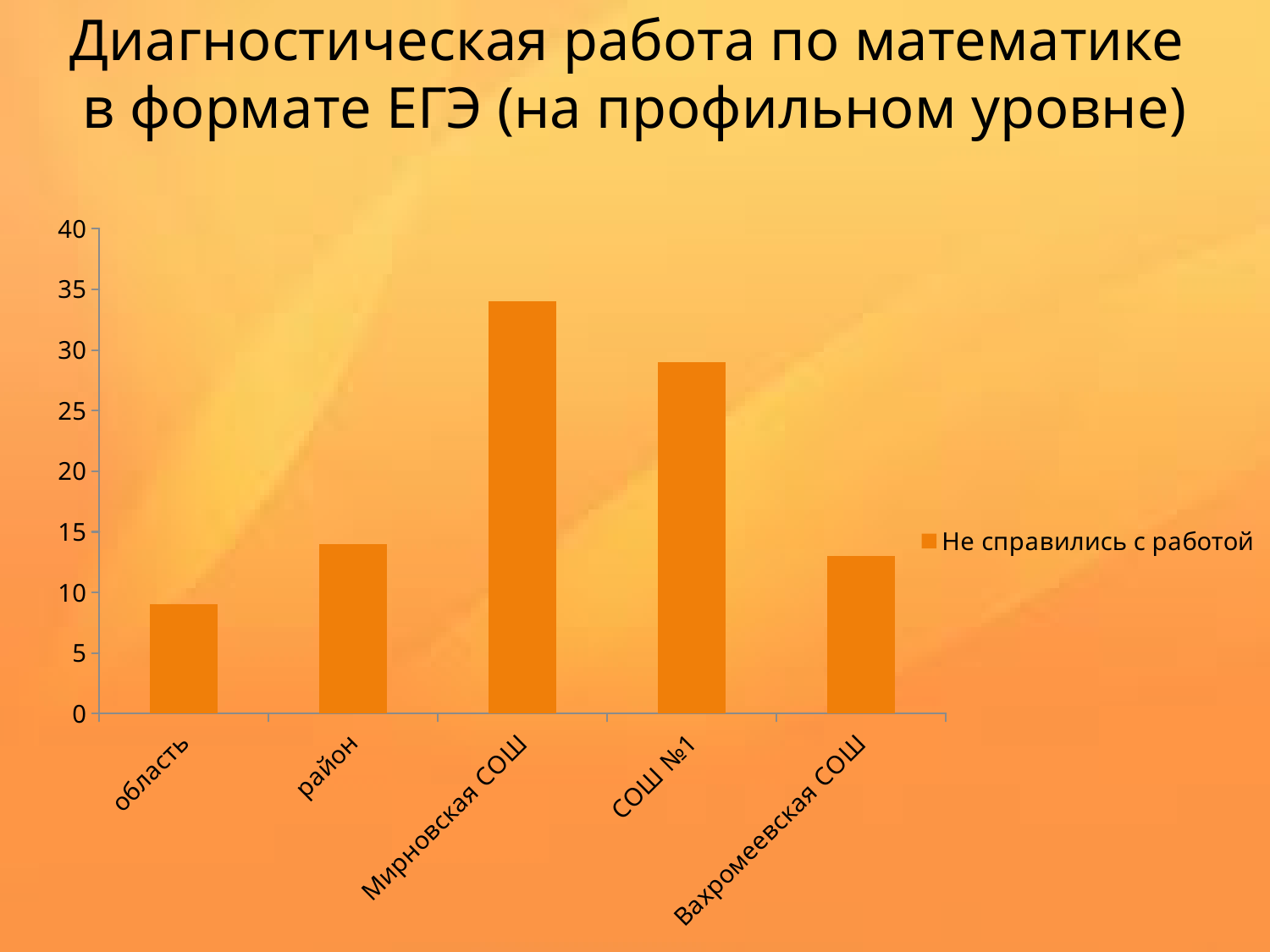
What is the name of the series shown in the chart legend? Не справились с работой Which category has the highest bar in the chart? Мирновская СОШ What kind of chart is shown on the slide? bar chart Which is larger, the value for Мирновская СОШ or the value for СОШ №1? Мирновская СОШ How many categories are shown on the x axis of the chart? 5 Which is larger, the value for район or the value for область? район Is the value for район greater or less than 10? greater Is the value for Мирновская СОШ greater or less than 30? greater Is the value for СОШ №1 greater or less than 25? greater Which category has the lowest bar in the chart? область How many series does the chart legend list? 1